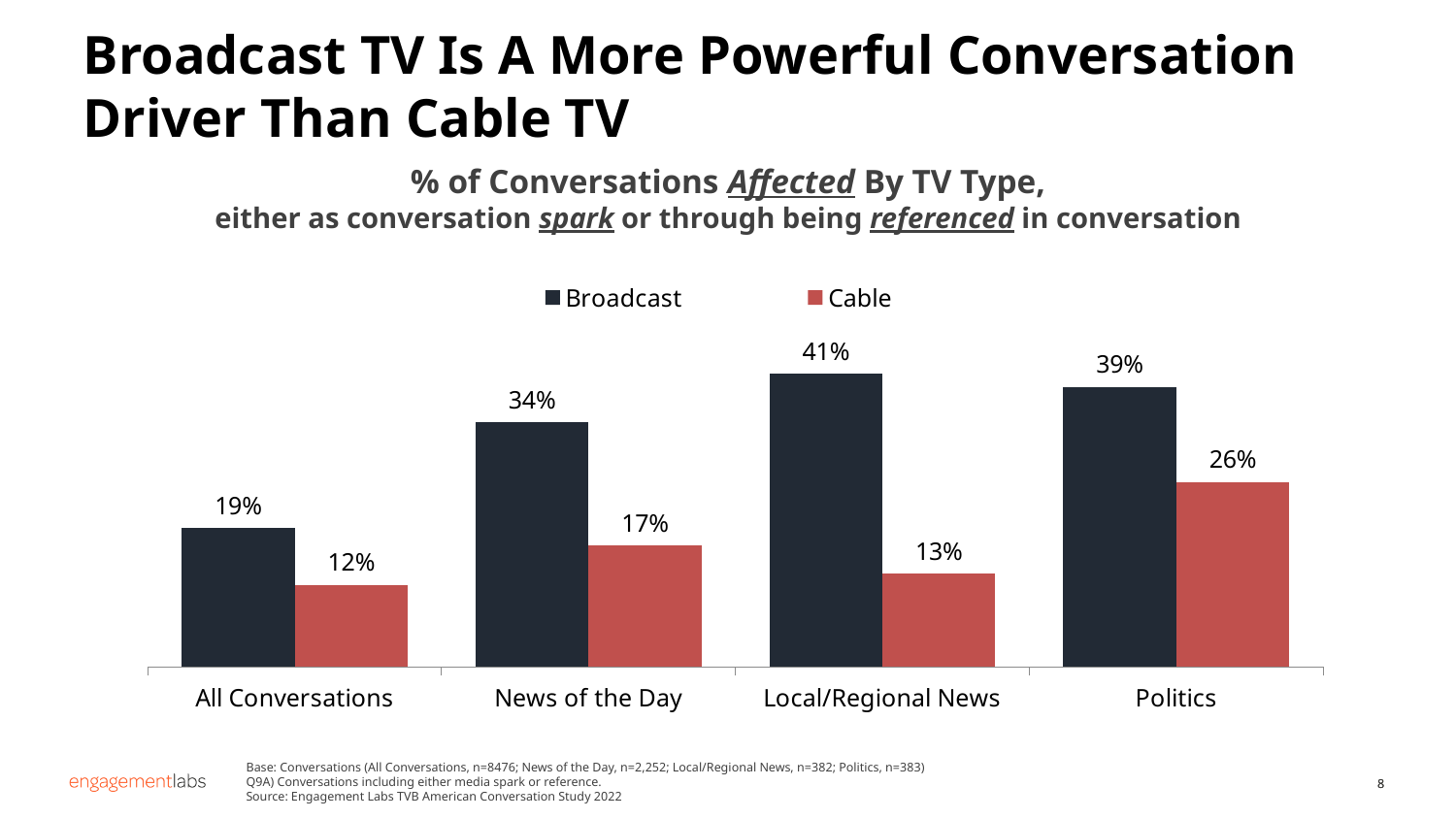
Which is larger for Politics, the Broadcast value or the Cable value? Broadcast What is the Broadcast value for Local/Regional News? 41% What is the difference between the Broadcast and Cable values for News of the Day? 17% Which category has the highest Broadcast value? Local/Regional News How many categories are shown on the x axis? 4 How many series does the legend list? 2 What is the Cable value for Politics? 26% What kind of chart is shown on the slide? Bar chart What is the Cable value for All Conversations? 12% Which series is shown in red? Cable Which category has the lowest Cable value? All Conversations What is the difference between the Broadcast and Cable values for Local/Regional News? 28%